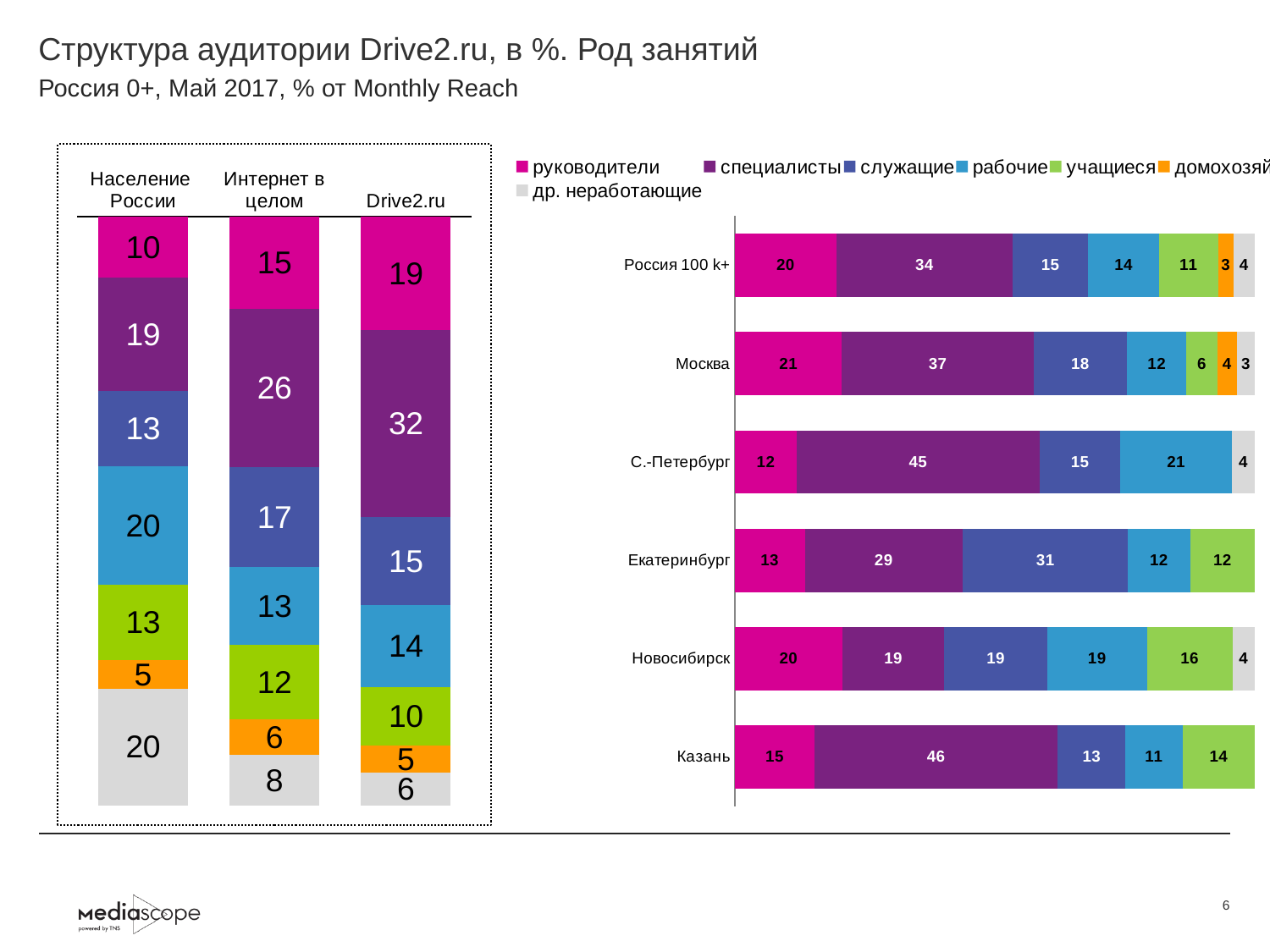
In the left chart, which of the three bars has the largest purple (специалисты) segment? Drive2.ru How many series does the legend of the right chart list? 7 In the right chart, how many cities/regions are listed on the vertical axis? 6 In the left chart, how many bars (categories) are shown? 3 In the right chart, which city has the lowest value for руководители (pink segment)? С.-Петербург In the right chart, what is the value for рабочие (blue segment) in С.-Петербург? 21 In the left chart, what is the value for специалисты (purple segment) in the Drive2.ru bar? 32 In the left chart, what is the value of the top (pink) segment for Население России? 10 In the right chart, which city has the highest value for специалисты? Казань In the left chart, what is the difference between the pink (руководители) segment for Drive2.ru and for Интернет в целом? 4 In the right chart, is the руководители value for Москва larger or smaller than for Екатеринбург? larger In the right chart, what is the value for специалисты in Казань? 46